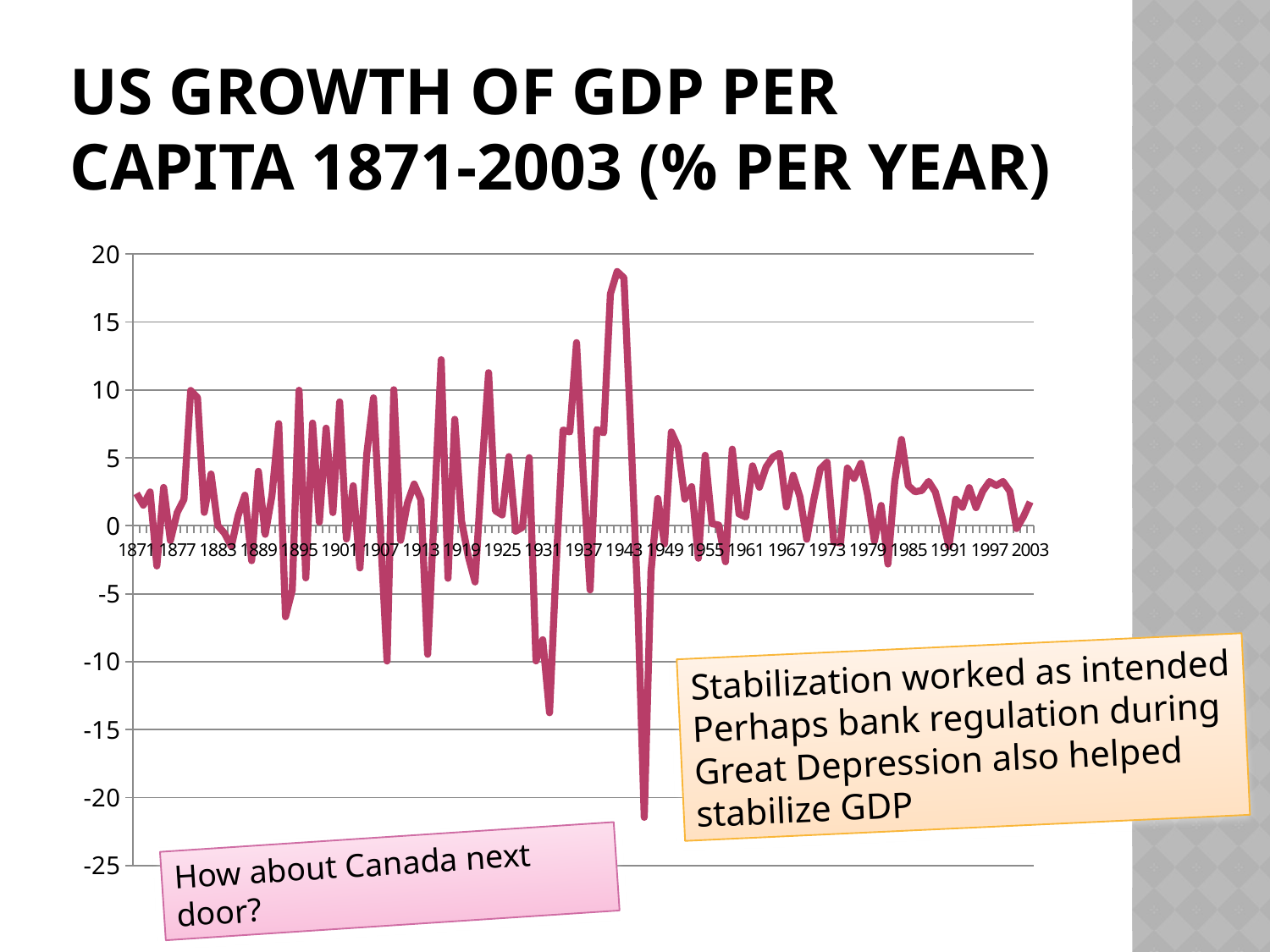
Which is larger: the peak of the line in the early 1940s or the peak around 1895? the peak in the early 1940s Is the lowest point of the line, in the mid 1940s, greater or less than -20? less What is the lowest value shown on the y axis of the chart? -25 What is the last year labelled on the x axis of the chart? 2003 Is the highest peak of the line, in the early 1940s, greater or less than 15? greater Is the value at the deep trough in the early 1930s greater or less than -10? less What is the title of the chart on the slide? US Growth of GDP per Capita 1871-2003 (% per year) What is the first year labelled on the x axis of the chart? 1871 How many year labels are shown along the x axis of the chart? 23 What is the highest value shown on the y axis of the chart? 20 What kind of chart is shown on the slide? line chart